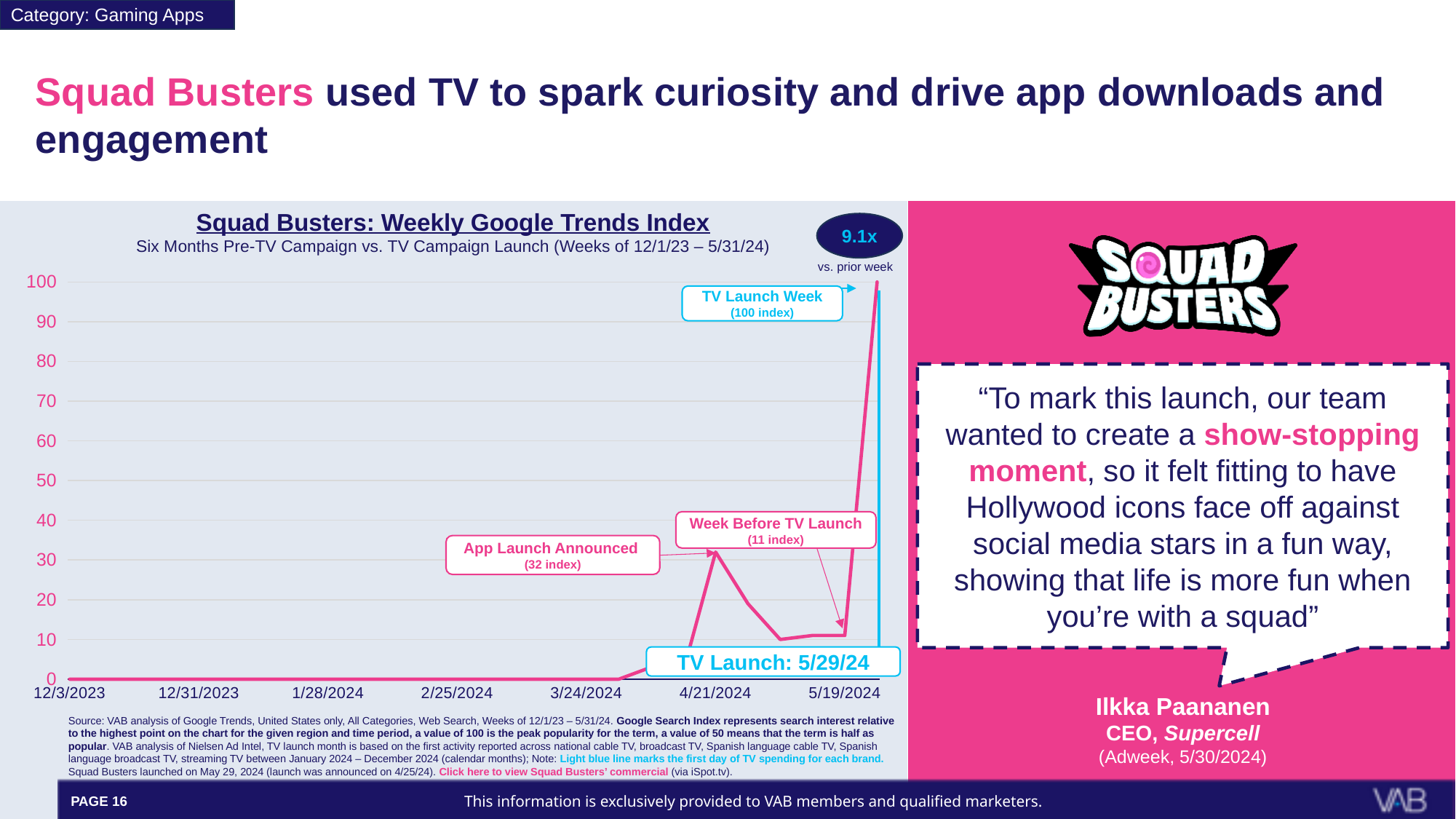
What is the Google Trends index value for the week the App Launch was Announced? 32 What kind of chart is shown on the slide? line chart What is the Google Trends index value for the Week Before TV Launch? 11 How many date labels are shown on the x axis? 7 What is the difference in index between the TV Launch Week and the Week Before TV Launch? 89 Which labeled week has the highest Google Trends index? TV Launch Week Which has a higher index: the App Launch Announced week or the Week Before TV Launch? App Launch Announced Is the index value for the week of 12/3/2023 greater or less than 10? less What is the difference in index between the App Launch Announced week and the Week Before TV Launch? 21 What date is given for the TV Launch on the chart? 5/29/24 What is the Google Trends index value for the TV Launch Week? 100 By what multiple did the index increase in the TV launch week versus the prior week, according to the callout? 9.1x